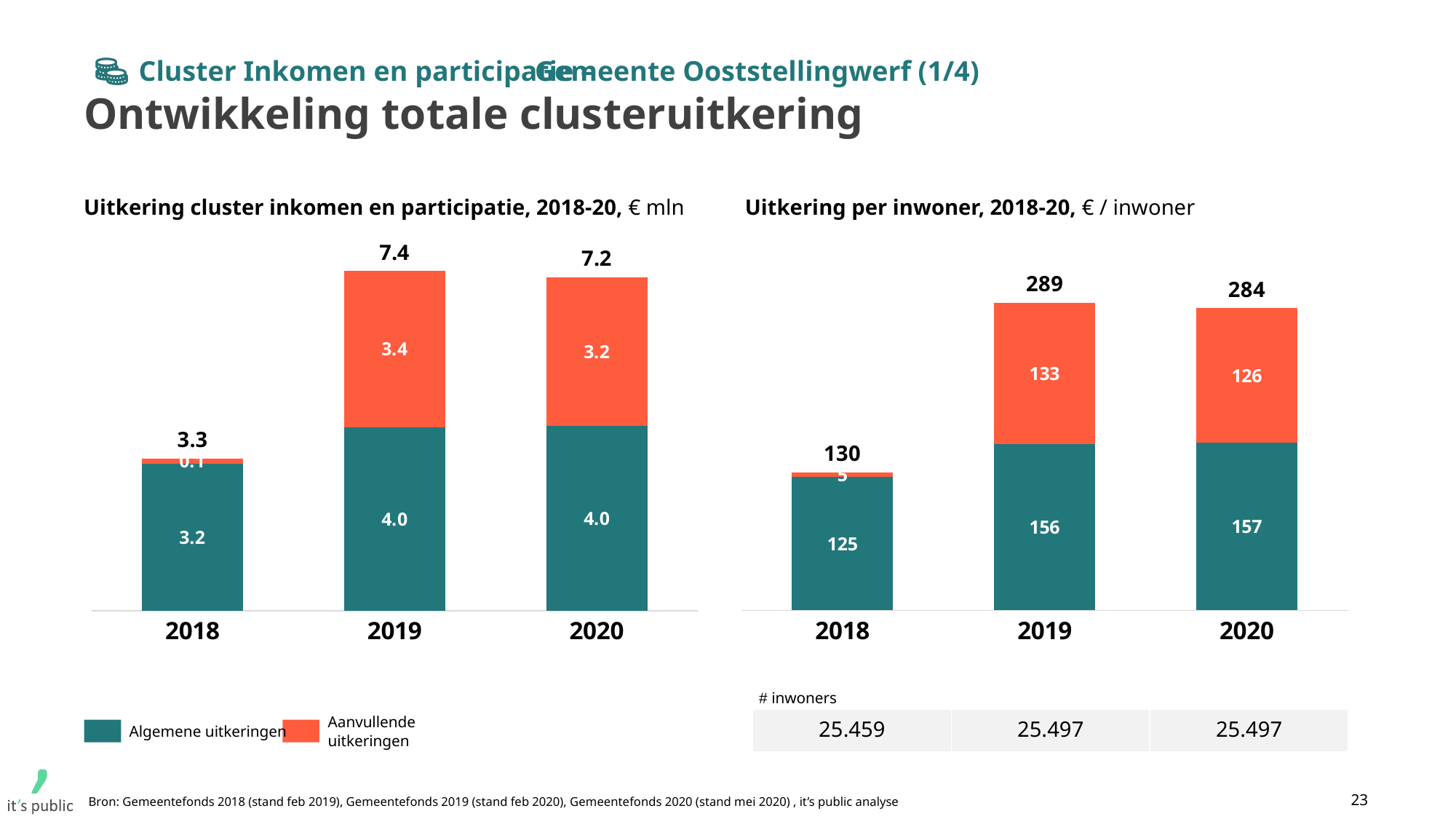
In the right chart (Uitkering per inwoner), what is the difference between the totals for 2019 and 2018? 159 What kind of chart is the left chart (Uitkering cluster inkomen en participatie)? stacked bar chart In the right chart (Uitkering per inwoner), is the Aanvullende uitkeringen value for 2019 larger or smaller than for 2020? larger In the left chart (Uitkering cluster inkomen en participatie), what is the value of Aanvullende uitkeringen for 2020? 3.2 In the right chart (Uitkering per inwoner), which year has the lowest total? 2018 In the left chart (Uitkering cluster inkomen en participatie), what is the total of the stacked bar for 2018? 3.3 In the right chart (Uitkering per inwoner), what is the value of Algemene uitkeringen for 2020? 157 In the left chart (Uitkering cluster inkomen en participatie), what is the value of Algemene uitkeringen for 2019? 4.0 In the left chart (Uitkering cluster inkomen en participatie), what is the difference between the totals for 2019 and 2020? 0.2 How many series does the legend list for the charts on this slide? 2 In the right chart (Uitkering per inwoner), what is the value of Aanvullende uitkeringen for 2019? 133 In the left chart (Uitkering cluster inkomen en participatie), which year has the highest total? 2019